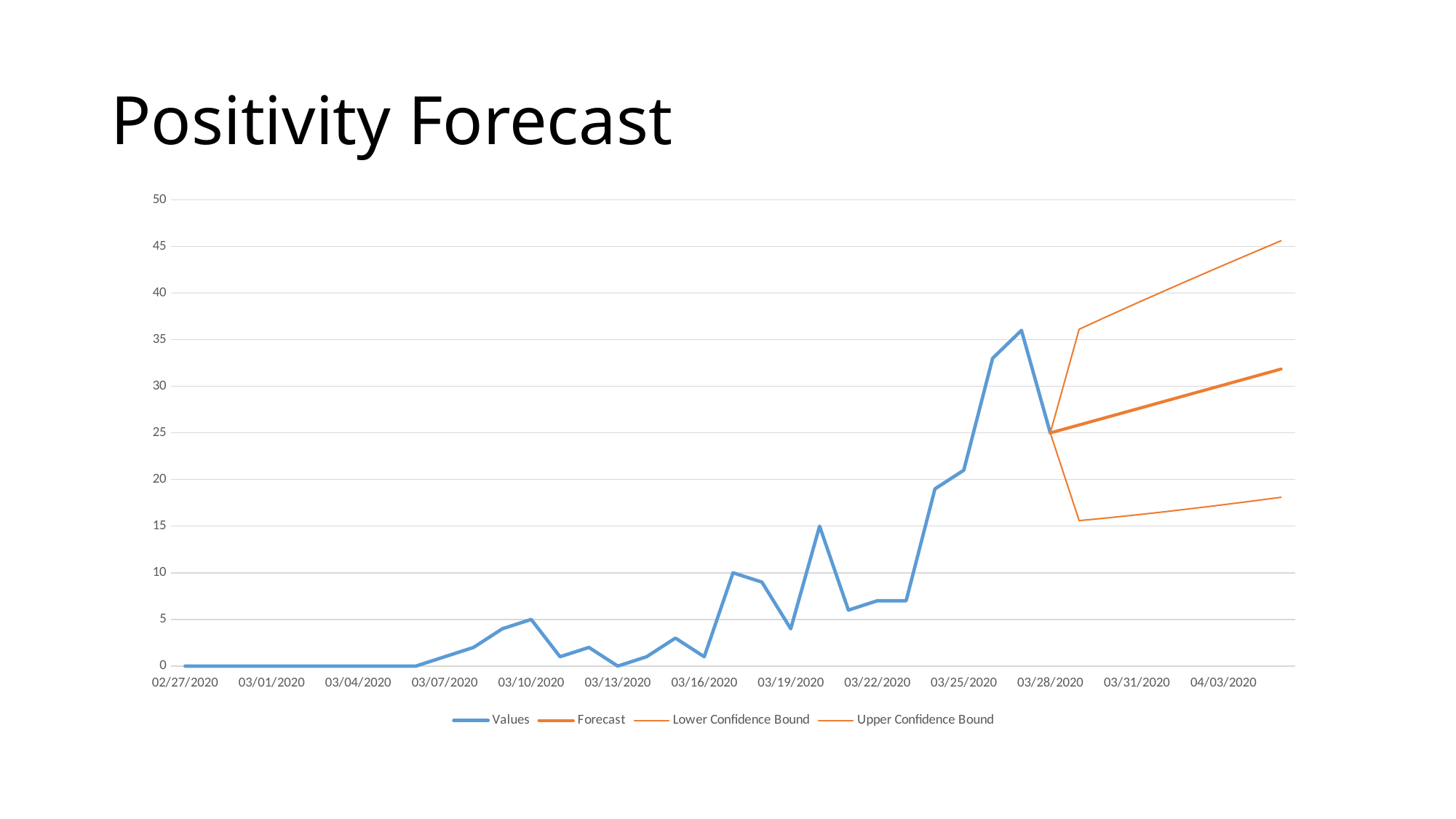
On 04/03/2020, which is larger: the Upper Confidence Bound or the Lower Confidence Bound? Upper Confidence Bound What is the value of the Values series on 03/28/2020? 25 Does the Forecast series rise or fall from 03/28/2020 onward? rise What is the value of the Values series on 03/10/2020? 5 How many series does the legend list? 4 Which series is drawn in blue? Values Is the Values series on 03/22/2020 greater or less than 10? less What kind of chart is shown on the slide? line chart Is the Lower Confidence Bound on 03/31/2020 greater or less than 20? less Is the Upper Confidence Bound on 04/03/2020 greater or less than 40? greater What is the value of the Values series on 03/13/2020? 0 What is the title of the slide containing the chart? Positivity Forecast